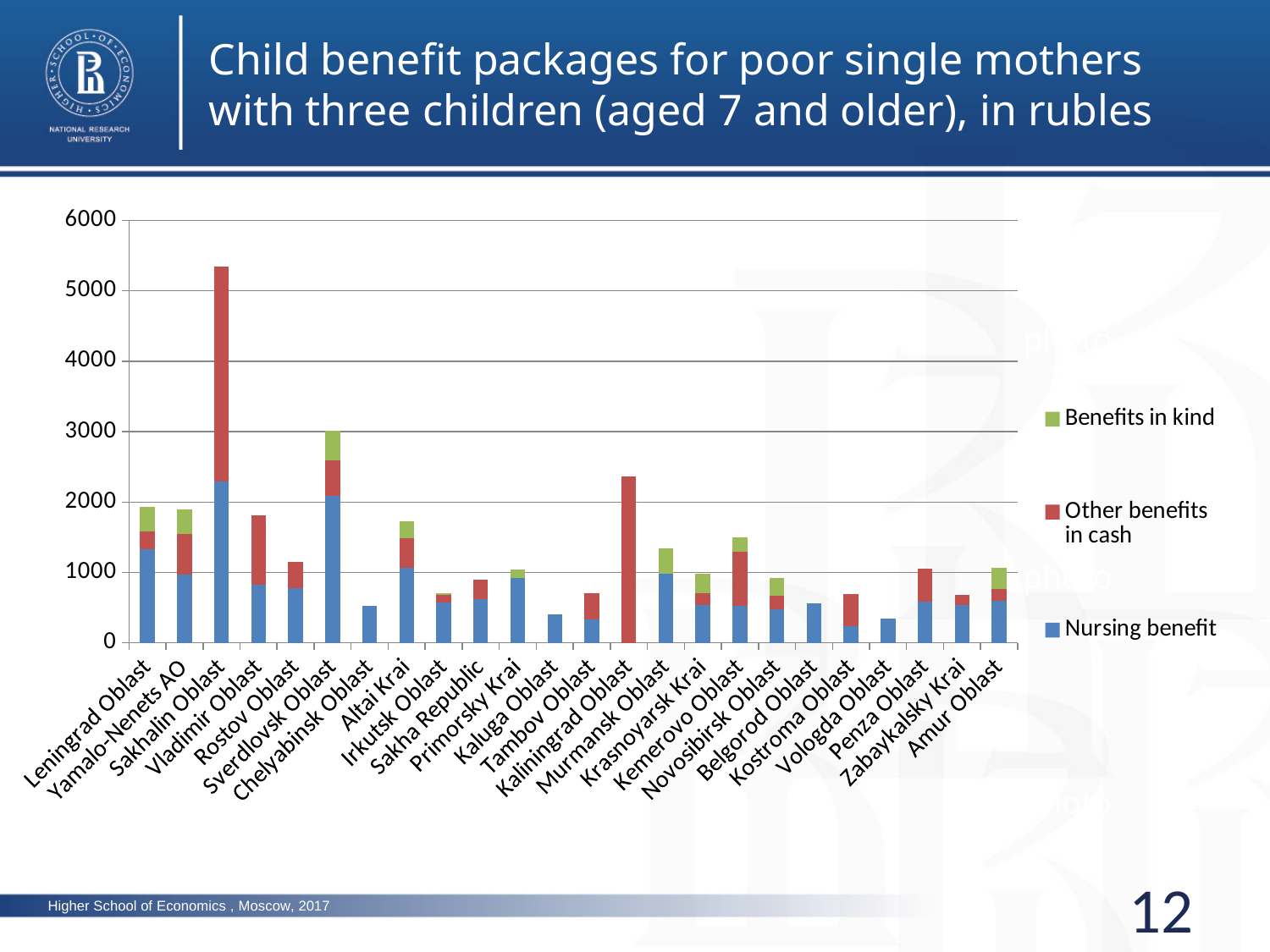
Is the total value for Kaliningrad Oblast greater or less than 2000? greater How many series does the legend list? 3 Which has the larger total benefit package, Sakhalin Oblast or Sverdlovsk Oblast? Sakhalin Oblast Is the total value for Chelyabinsk Oblast greater or less than 1000? less What is the title of the chart on the slide? Child benefit packages for poor single mothers with three children (aged 7 and older), in rubles Is the total value for Sverdlovsk Oblast greater or less than 2000? greater Which series is shown in blue in the legend? Nursing benefit Which region has the highest total child benefit package? Sakhalin Oblast Which has the larger total benefit package, Kaliningrad Oblast or Murmansk Oblast? Kaliningrad Oblast What kind of chart is shown on the slide? Stacked bar chart How many regions are shown on the x axis of the chart? 24